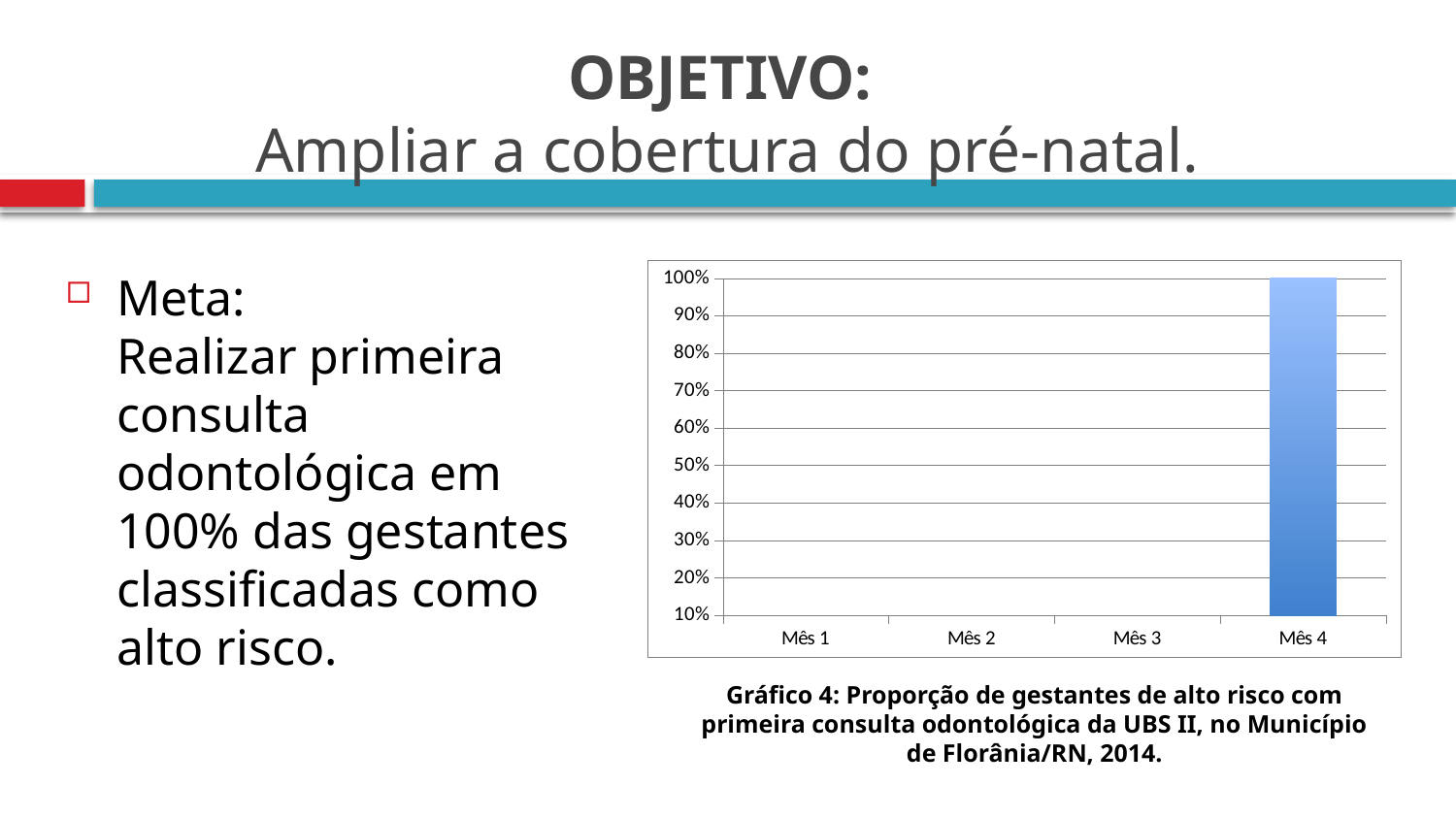
What kind of chart is shown on the slide? bar chart Which is larger, the value for Mês 1 or the value for Mês 4? Mês 4 Is the value for Mês 4 greater or less than 50%? greater Is the value for Mês 4 greater or less than 90%? greater What is the lowest tick value shown on the y axis of the chart? 10% How many months in the chart have a visible bar? 1 What is the number of the chart according to its caption (Gráfico ...)? Gráfico 4 What is the value for Mês 4 in the chart? 100% Which month has the highest value in the chart? Mês 4 How many categories (months) are shown on the x axis of the chart? 4